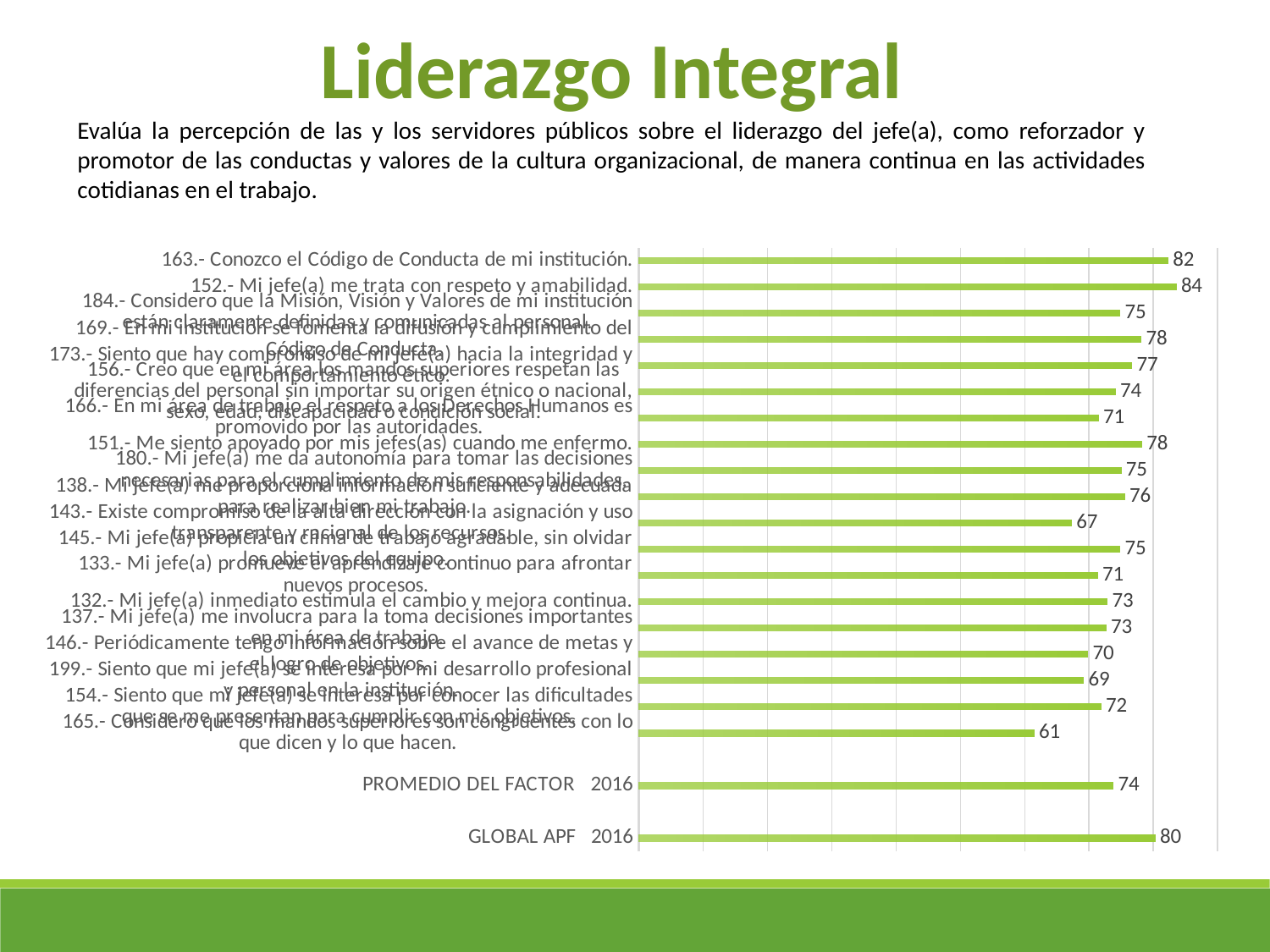
What value is shown for 'GLOBAL APF 2016'? 80 What is the difference between the value for 'GLOBAL APF 2016' and 'PROMEDIO DEL FACTOR 2016'? 6 What is the lowest value shown in the chart? 61 What value is shown for '152.- Mi jefe(a) me trata con respeto y amabilidad.'? 84 Which is larger: the value for '151.- Me siento apoyado por mis jefes(as) cuando me enfermo.' or for '132.- Mi jefe(a) inmediato estimula el cambio y mejora continua.'? 151.- Me siento apoyado por mis jefes(as) cuando me enfermo. What value is shown for '151.- Me siento apoyado por mis jefes(as) cuando me enfermo.'? 78 What is the title of the slide containing the chart? Liderazgo Integral What kind of chart is shown on the slide? Bar chart What value is shown for 'PROMEDIO DEL FACTOR 2016'? 74 How many bars are plotted in the chart? 21 What value is shown for '163.- Conozco el Código de Conducta de mi institución.'? 82 Which item has the highest value in the chart? 152.- Mi jefe(a) me trata con respeto y amabilidad.